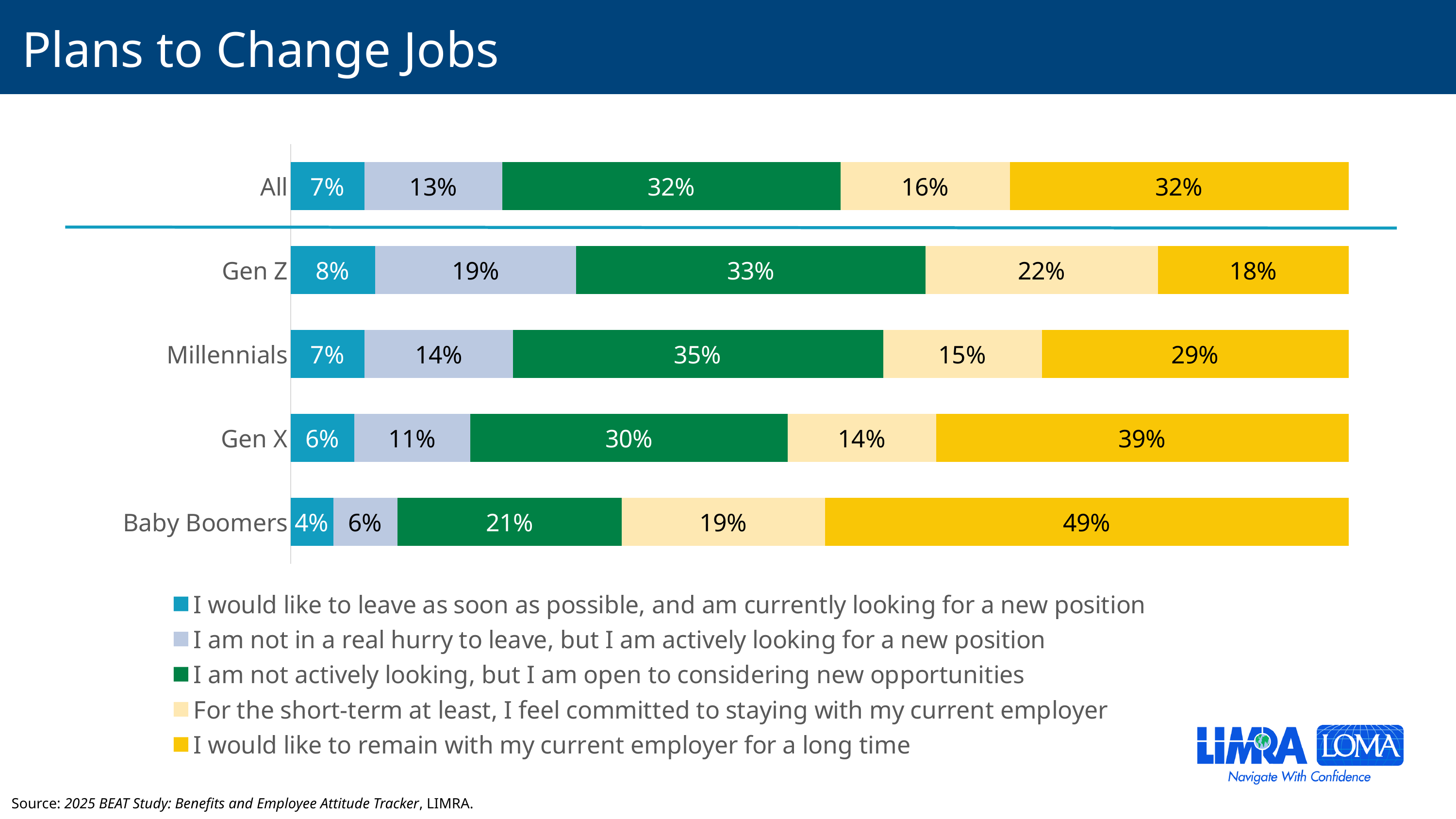
Which generation has the highest share who would like to remain with their current employer for a long time? Baby Boomers What kind of chart is shown on the slide? Stacked bar chart What is the combined share of Gen Z respondents who are actively looking for a new position (the first two segments)? 27% What percentage of Baby Boomers would like to remain with their current employer for a long time? 49% Which generation has the lowest share who would like to leave as soon as possible and are currently looking for a new position? Baby Boomers Which group has a larger share who feel committed to staying with their current employer for the short term: Gen Z or Millennials? Gen Z How many series does the legend list? 5 How many generation groups are shown on the chart, including All? 5 What is the difference between Gen X and Gen Z in the share who would like to remain with their current employer for a long time? 21 percentage points What percentage of Gen Z respondents are not in a real hurry to leave but are actively looking for a new position? 19% What is the title of the chart on the slide? Plans to Change Jobs What percentage of Millennials are not actively looking but are open to considering new opportunities? 35%